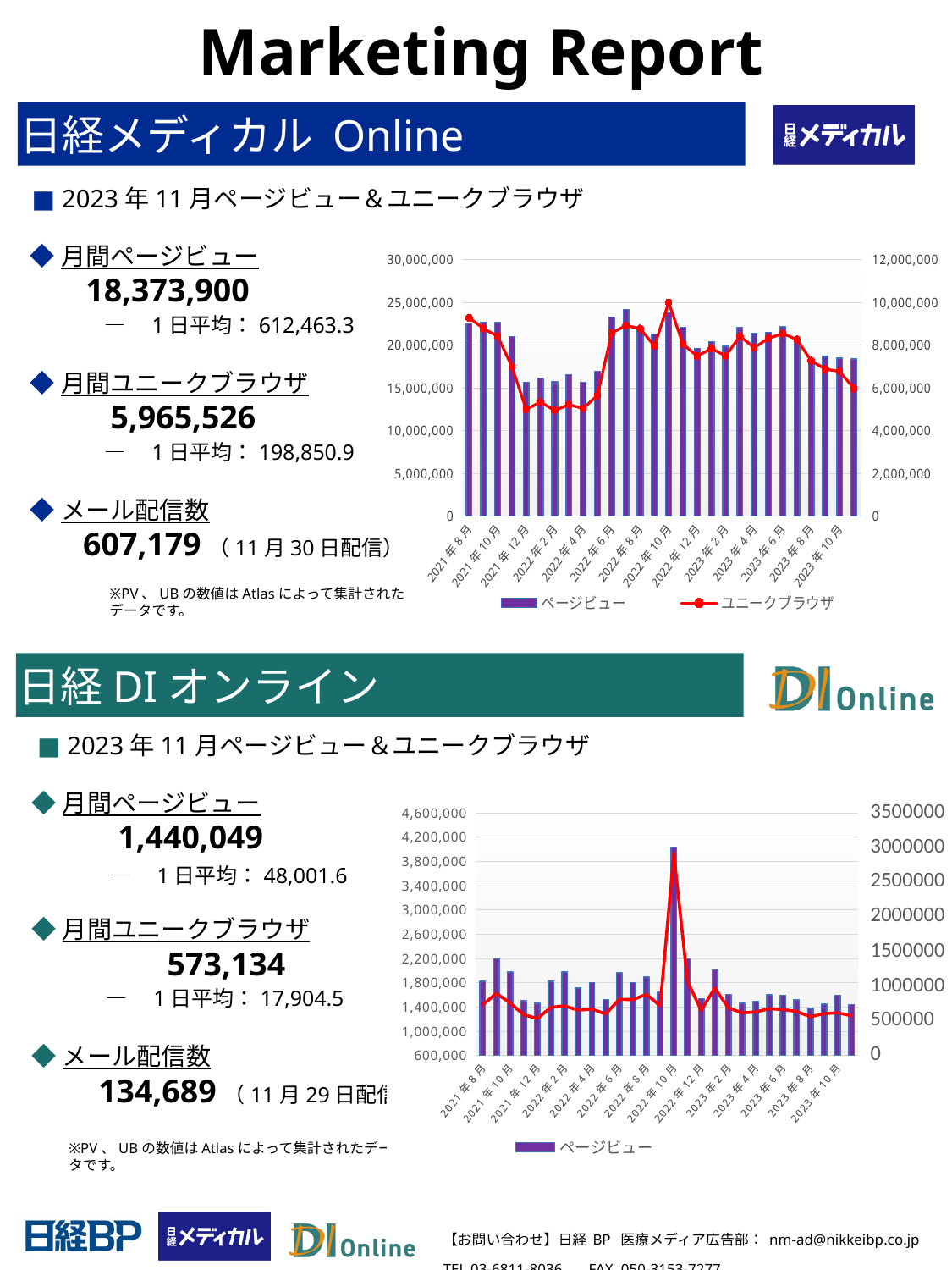
In the 日経メディカル Online chart, is the ページビュー bar for 2021年8月 greater or less than 20,000,000? greater In the 日経メディカル Online chart, which series is drawn as a red line? ユニークブラウザ In the 日経メディカル Online chart, is the ページビュー bar for 2021年12月 greater or less than 20,000,000? less In the 日経メディカル Online chart, do the ページビュー bars rise or fall from 2023年6月 to 2023年10月? fall In the 日経DIオンライン chart, which month has the highest ページビュー bar? 2022年10月 In the 日経DIオンライン chart, is the ページビュー bar for 2022年10月 greater or less than 3,000,000? greater How many series does the legend of the 日経DIオンライン chart list? 1 What kind of chart is shown in the 日経メディカル Online section? Combined bar and line chart How many series does the legend of the 日経メディカル Online chart list? 2 In the 日経メディカル Online chart, which month has the highest ユニークブラウザ value? 2022年10月